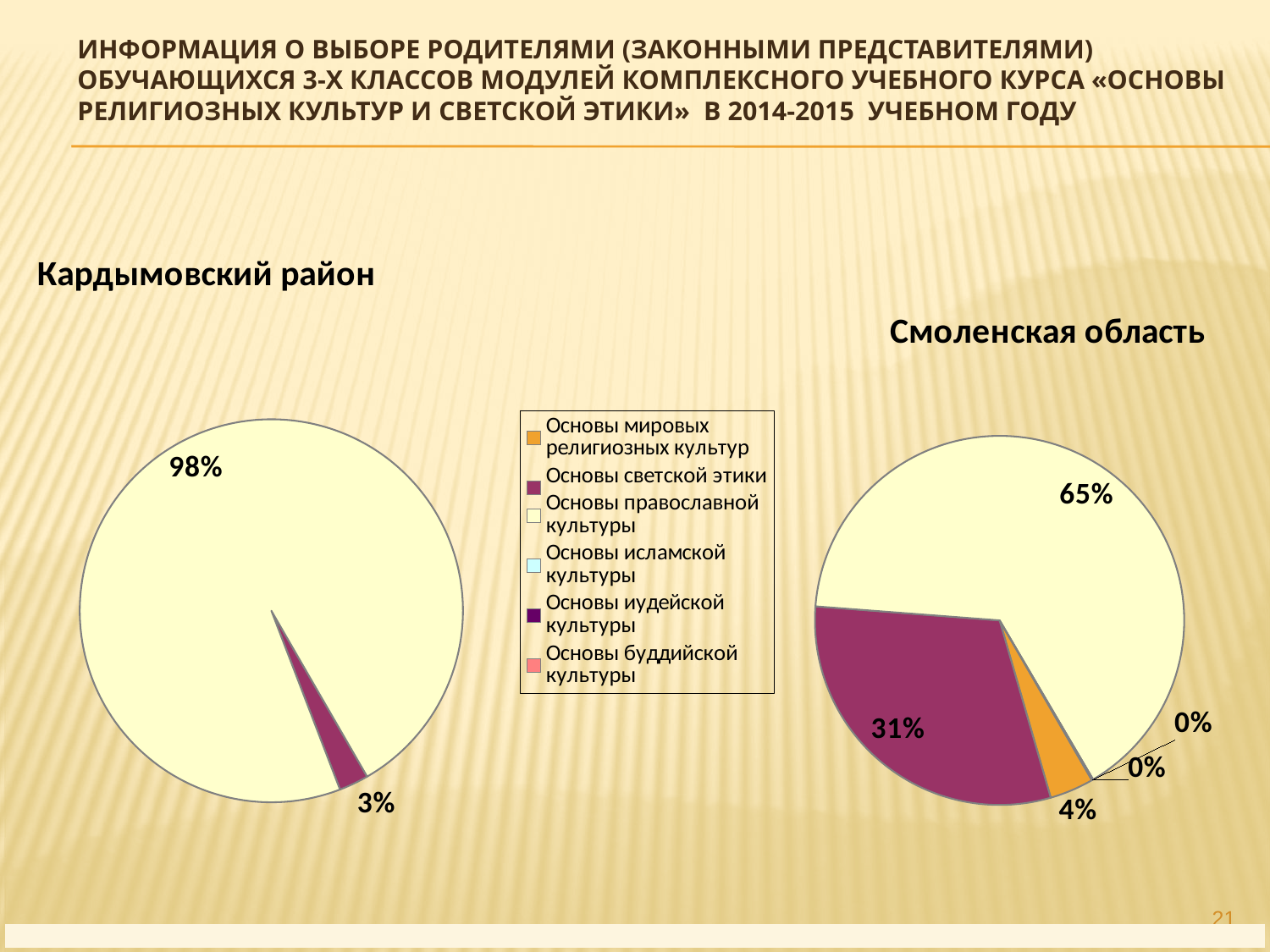
In the Кардымовский район chart, by how many percentage points does Основы православной культуры exceed Основы светской этики? 95 percentage points In the Смоленская область chart, what share is labelled for Основы светской этики? 31% In the Смоленская область chart, by how many percentage points does Основы православной культуры exceed Основы светской этики? 34 percentage points In the Кардымовский район chart, what share is labelled for Основы светской этики? 3% In the Смоленская область chart, which module has the largest slice? Основы православной культуры In the Кардымовский район chart, what share is labelled for Основы православной культуры? 98% In the Смоленская область chart, what share is labelled for Основы православной культуры? 65% In which chart, Кардымовский район or Смоленская область, is the share for Основы светской этики larger? Смоленская область What kind of chart is used for the Кардымовский район data? pie chart How many modules are listed in the legend shared by the two pie charts? 6 In the Смоленская область chart, what share is labelled for Основы мировых религиозных культур? 4% In the Смоленская область chart, which is larger: Основы светской этики or Основы мировых религиозных культур? Основы светской этики